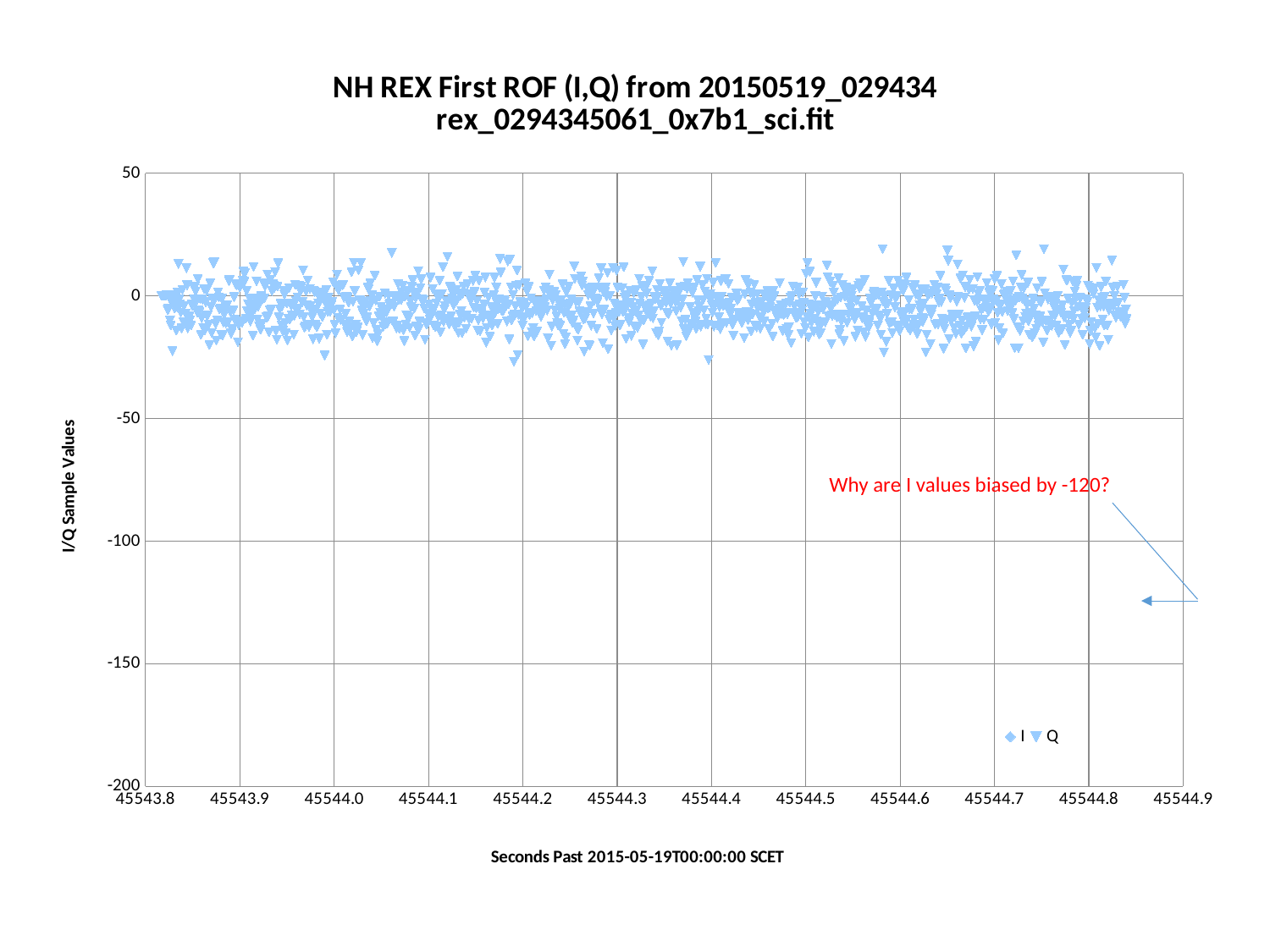
What is the highest value shown on the y axis? 50 What is the label of the y axis? I/Q Sample Values According to the red annotation, by how much are the I values biased? -120 Do the Q sample values show a clear rising or falling trend along the x axis, or stay roughly flat? roughly flat What is the lowest value shown on the y axis? -200 What kind of chart is shown on the slide? scatter chart Are the plotted Q sample values greater or less than -50? greater What are the names of the two series in the legend? I and Q Are the plotted Q sample values greater or less than 50? less How many series does the legend list? 2